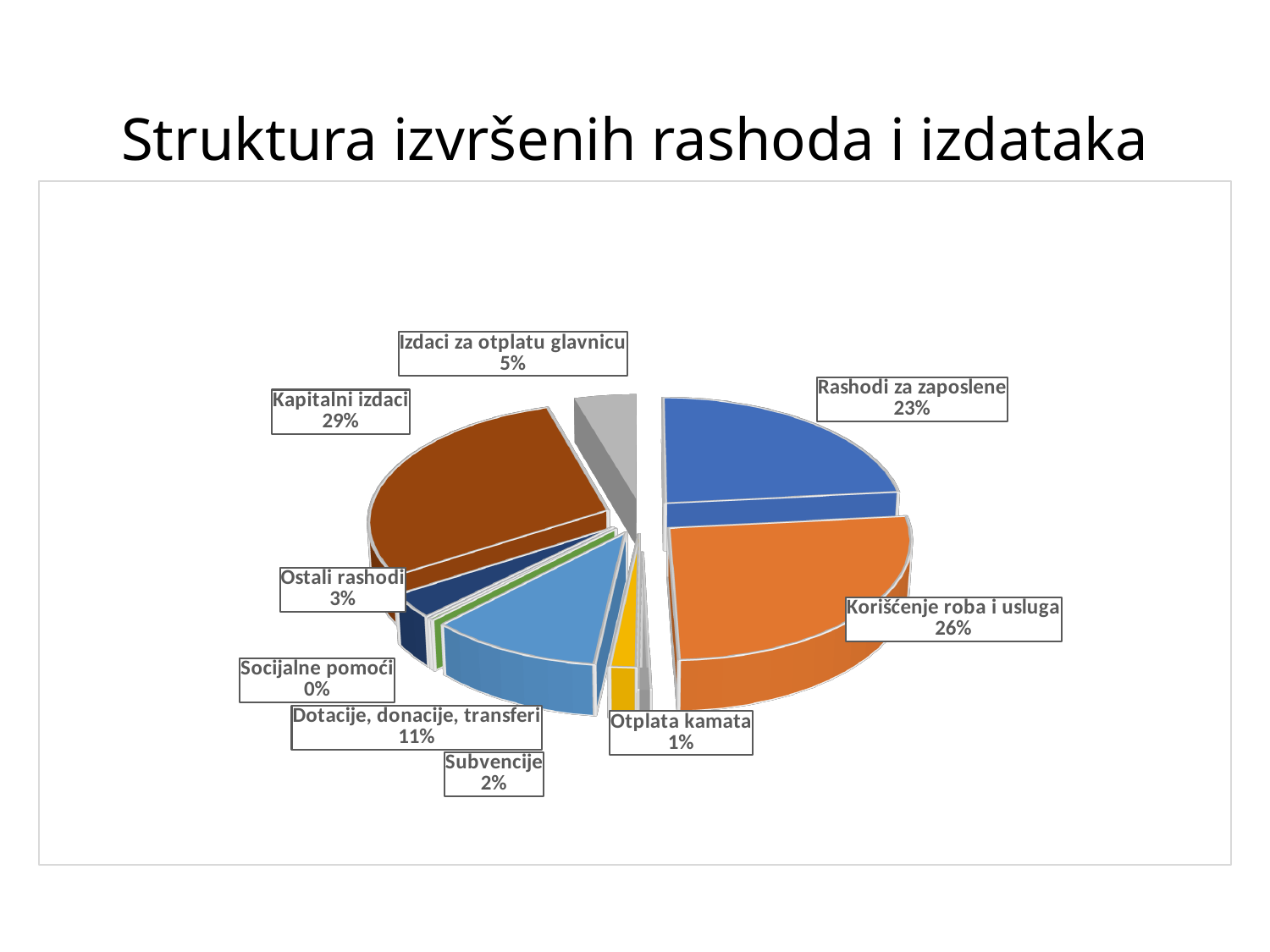
How many categories are shown in the pie chart? 9 What share of the pie is Kapitalni izdaci? 29% Which category has the smallest share of the pie? Socijalne pomoći What kind of chart is shown on the slide? Pie chart What share of the pie is Otplata kamata? 1% Which category has the largest share of the pie? Kapitalni izdaci What is the difference in percentage points between Kapitalni izdaci and Rashodi za zaposlene? 6 percentage points What share of the pie is Korišćenje roba i usluga? 26% Which is larger, Korišćenje roba i usluga or Rashodi za zaposlene? Korišćenje roba i usluga